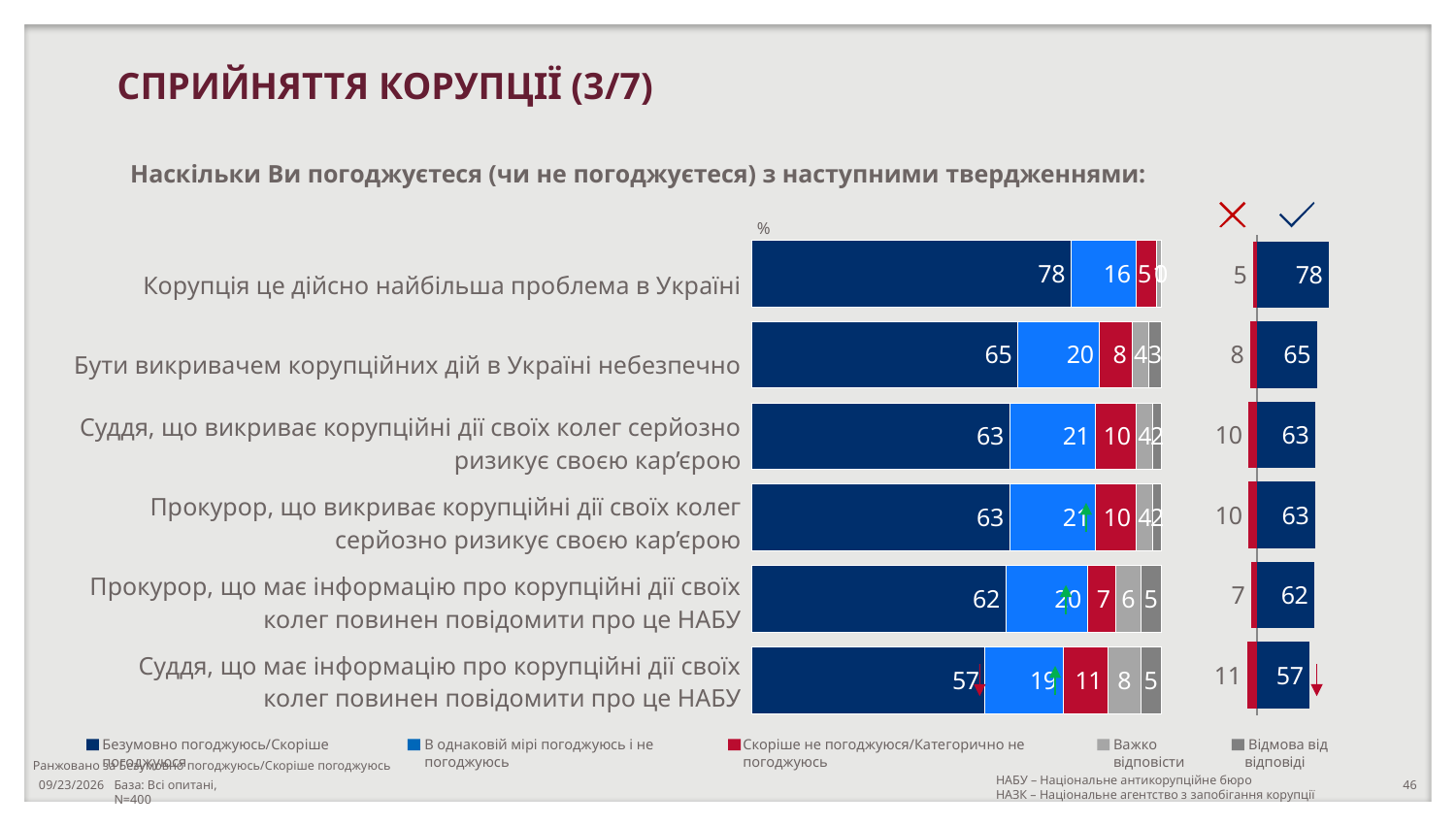
Which is larger: the 'Скоріше не погоджуюся/Категорично не погоджуюсь' value for 'Суддя, що має інформацію про корупційні дії своїх колег повинен повідомити про це НАБУ' or for 'Прокурор, що має інформацію про корупційні дії своїх колег повинен повідомити про це НАБУ'? Суддя, що має інформацію про корупційні дії своїх колег повинен повідомити про це НАБУ Which statement has the highest value for 'Безумовно погоджуюсь/Скоріше погоджуюсь'? Корупція це дійсно найбільша проблема в Україні What is the difference between the 'Безумовно погоджуюсь/Скоріше погоджуюсь' values for 'Корупція це дійсно найбільша проблема в Україні' and 'Бути викривачем корупційних дій в Україні небезпечно'? 13 How many series does the legend list? 5 What is the value of 'Важко відповісти' for 'Прокурор, що має інформацію про корупційні дії своїх колег повинен повідомити про це НАБУ'? 6 What is the value of 'В однаковій мірі погоджуюсь і не погоджуюсь' for 'Бути викривачем корупційних дій в Україні небезпечно'? 20 What is the value of 'Безумовно погоджуюсь/Скоріше погоджуюсь' for 'Корупція це дійсно найбільша проблема в Україні'? 78 Which statement has the lowest value for 'Безумовно погоджуюсь/Скоріше погоджуюсь'? Суддя, що має інформацію про корупційні дії своїх колег повинен повідомити про це НАБУ What is the total of the stacked bar for 'Бути викривачем корупційних дій в Україні небезпечно'? 100 What type of chart is shown on the slide? Stacked bar chart How many statements (categories) are plotted in the chart? 6 What is the value of 'Скоріше не погоджуюся/Категорично не погоджуюсь' for 'Суддя, що має інформацію про корупційні дії своїх колег повинен повідомити про це НАБУ'? 11